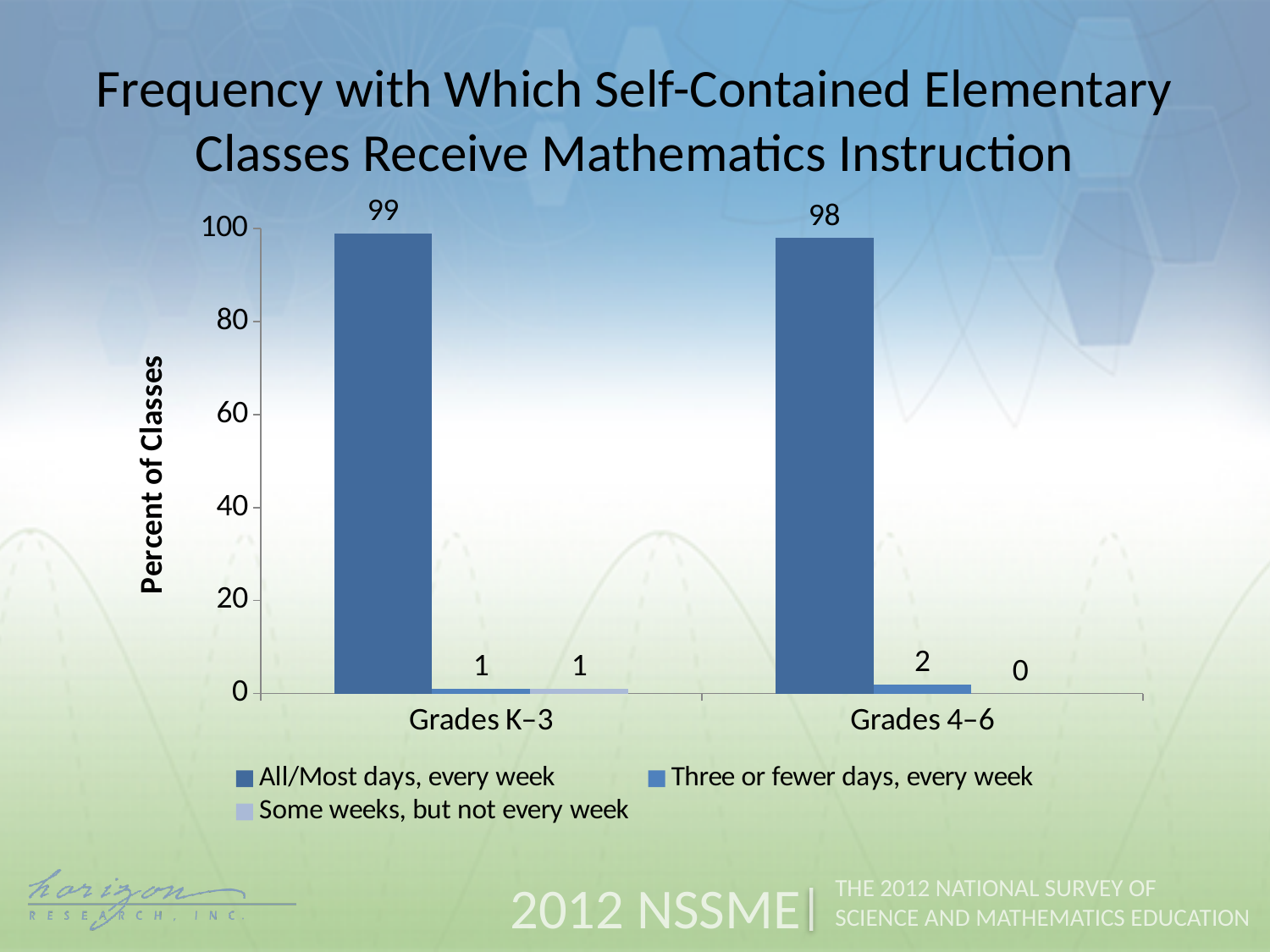
What is the value for "Three or fewer days, every week" for Grades 4–6? 2 What is the value for "All/Most days, every week" for Grades 4–6? 98 Which is larger: "Three or fewer days, every week" for Grades K–3 or for Grades 4–6? Grades 4–6 Which series has the highest value for Grades K–3? All/Most days, every week How many series does the legend list? 3 What is the difference between the "All/Most days, every week" values for Grades K–3 and Grades 4–6? 1 How many grade-level categories are shown on the x axis? 2 What is the value for "All/Most days, every week" for Grades K–3? 99 Which series has the lowest value for Grades 4–6? Some weeks, but not every week What is the value for "Some weeks, but not every week" for Grades 4–6? 0 What is the value for "Some weeks, but not every week" for Grades K–3? 1 What kind of chart is shown on the slide? Bar chart